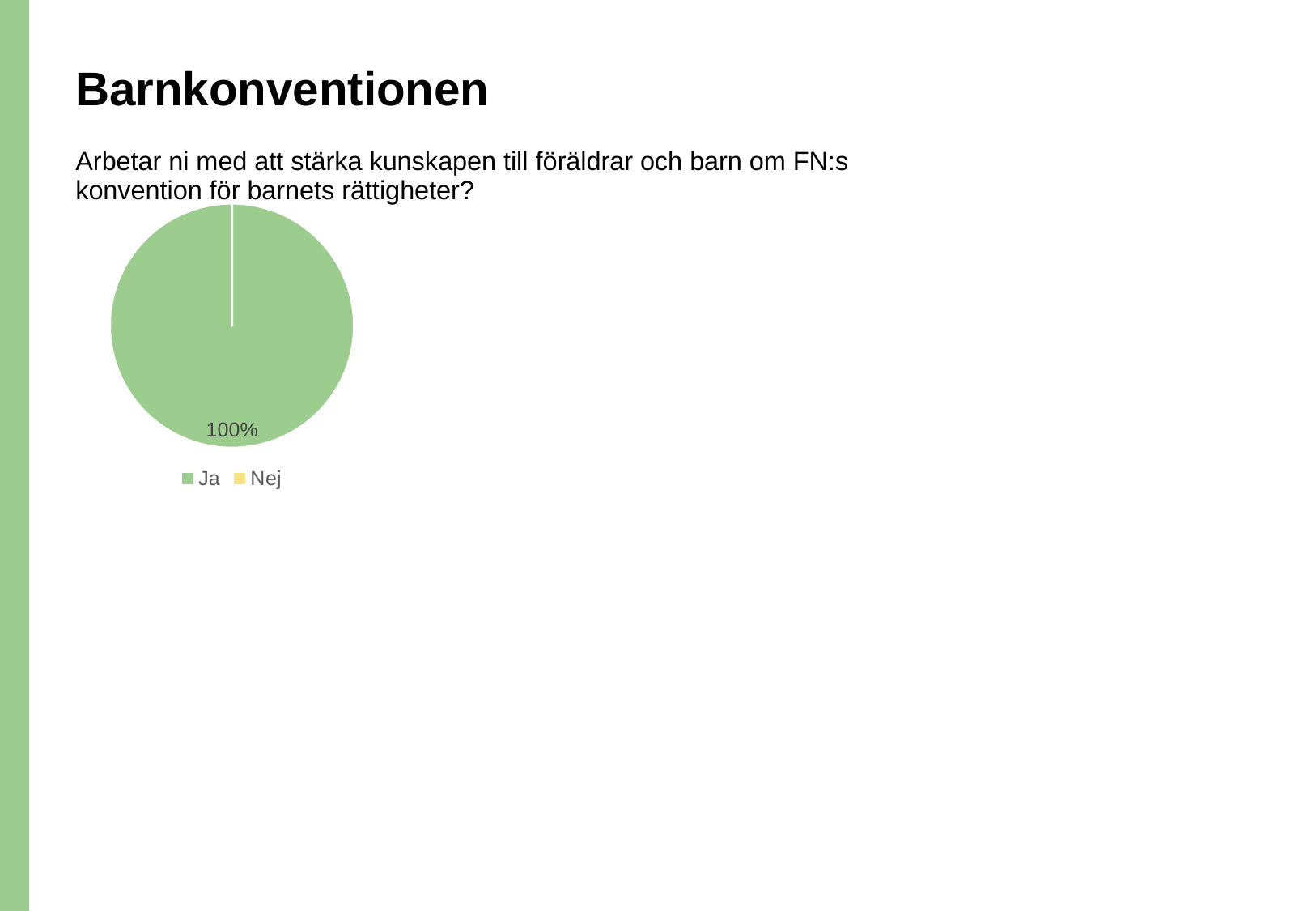
What colour is used for "Ja" in the chart? green Which category has the largest share of the pie? Ja What colour is used for "Nej" in the legend? yellow Which category has the smallest share of the pie? Nej What kind of chart is shown on the slide? pie chart What share of the pie does "Ja" represent? 100% How many entries does the legend list? 2 What is the only data label printed on the pie chart? 100% Which is larger, the share for "Ja" or the share for "Nej"? Ja